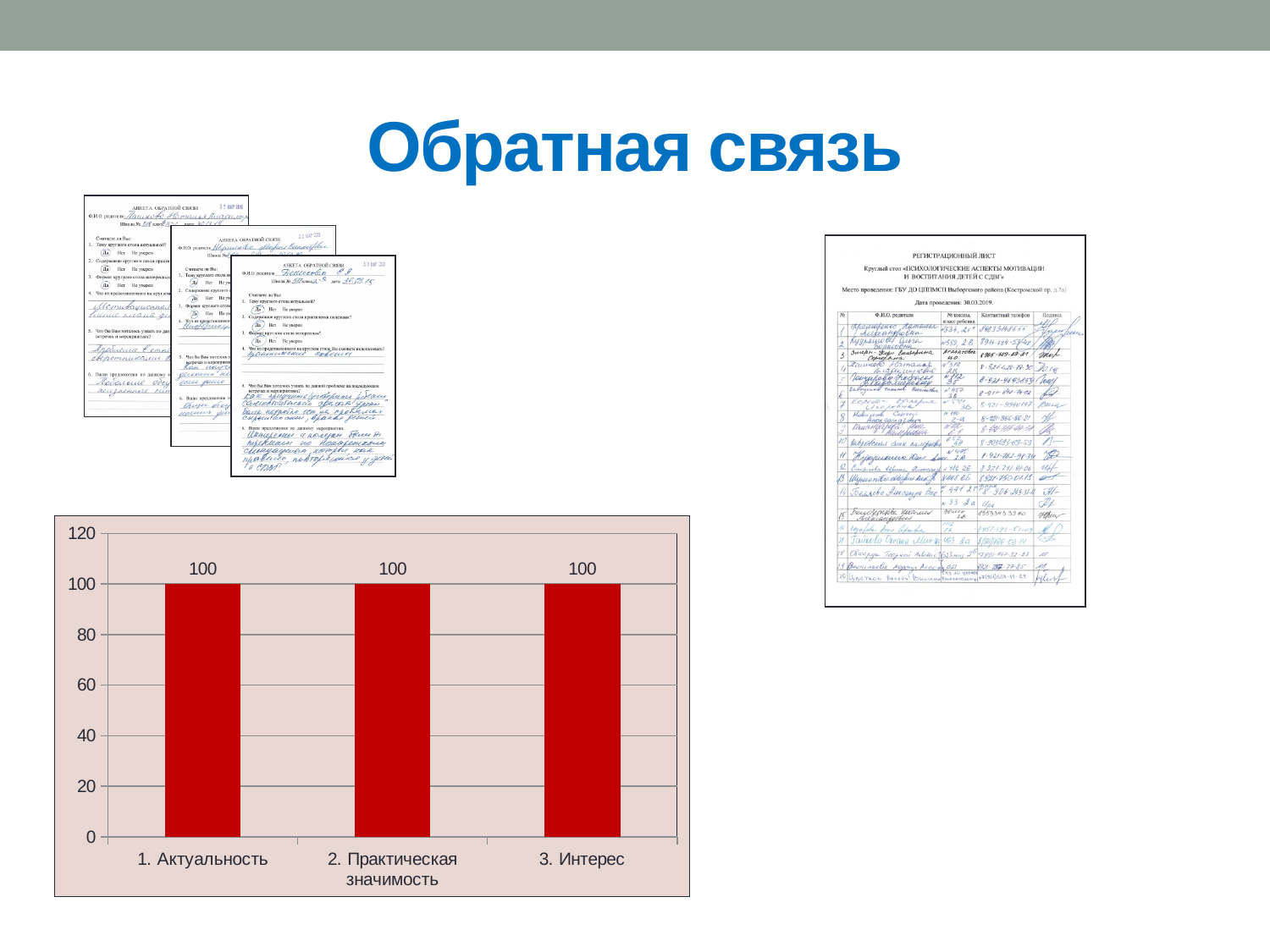
What is the value for "2. Практическая значимость"? 100 What colour are the bars in the chart? Red What is the value for "1. Актуальность"? 100 What is the difference between the values for "1. Актуальность" and "3. Интерес"? 0 What kind of chart is shown on the slide? Bar chart Do the values rise, fall, or stay the same across the categories from left to right? Stay the same What is the value for "3. Интерес"? 100 How many categories are shown on the x axis of the chart? 3 Is the value for "3. Интерес" greater or less than 120? less What is the title of the slide containing the chart? Обратная связь What is the highest value shown on the y axis of the chart? 120 Is the value for "2. Практическая значимость" greater or less than 80? greater